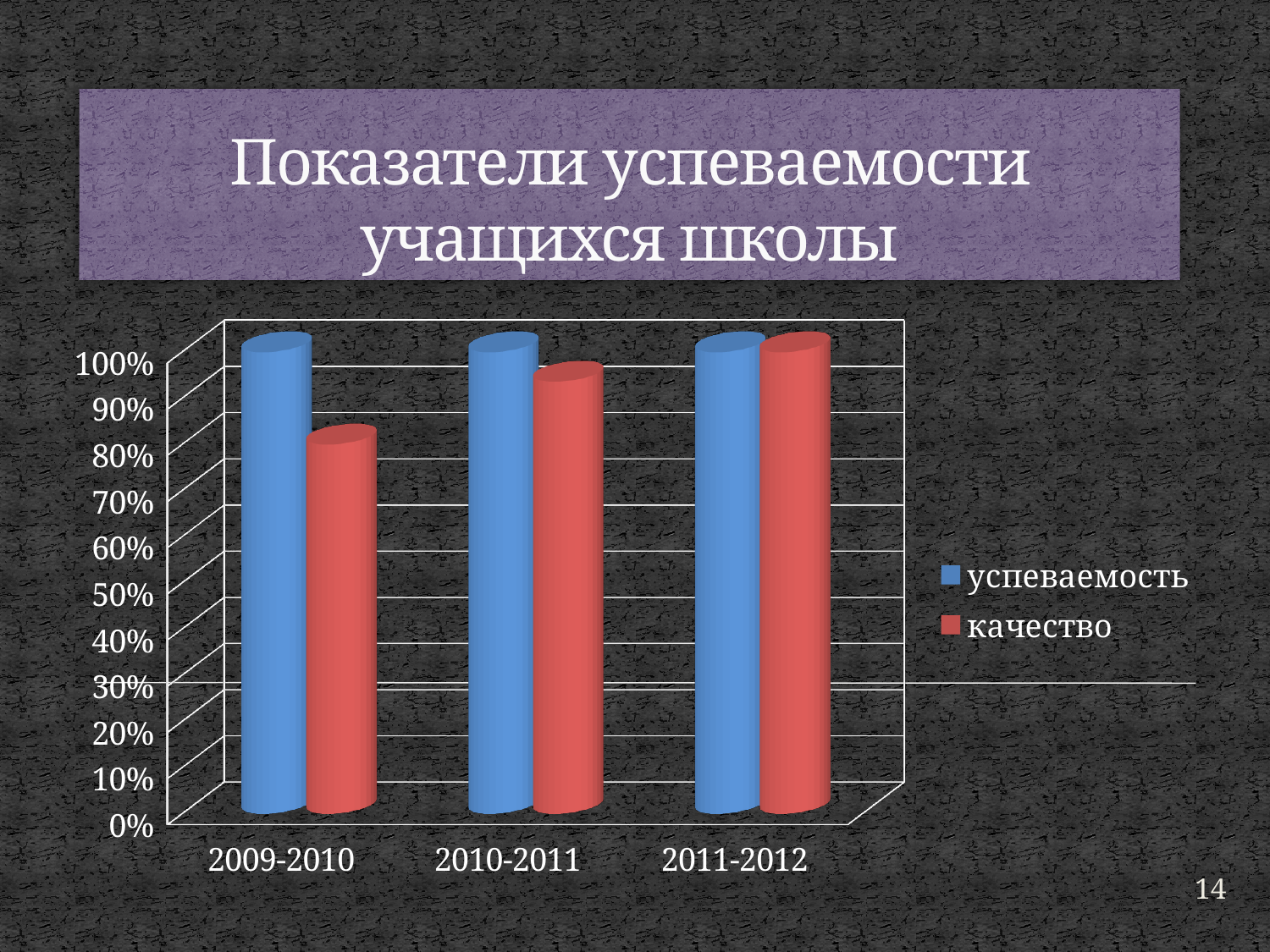
What is the title of the chart on the slide? Показатели успеваемости учащихся школы How many school-year categories are shown on the x axis? 3 Is the value for качество in 2009-2010 greater or less than 90%? less Is the value for качество in 2009-2010 greater or less than 70%? greater Does качество rise or fall from 2009-2010 to 2011-2012? rise Is the value for качество in 2010-2011 greater or less than 80%? greater In which school year is качество the lowest? 2009-2010 In 2009-2010, which is larger: успеваемость or качество? успеваемость How many series does the legend list? 2 What kind of chart is shown on the slide? bar chart Which series is shown in red in the legend? качество